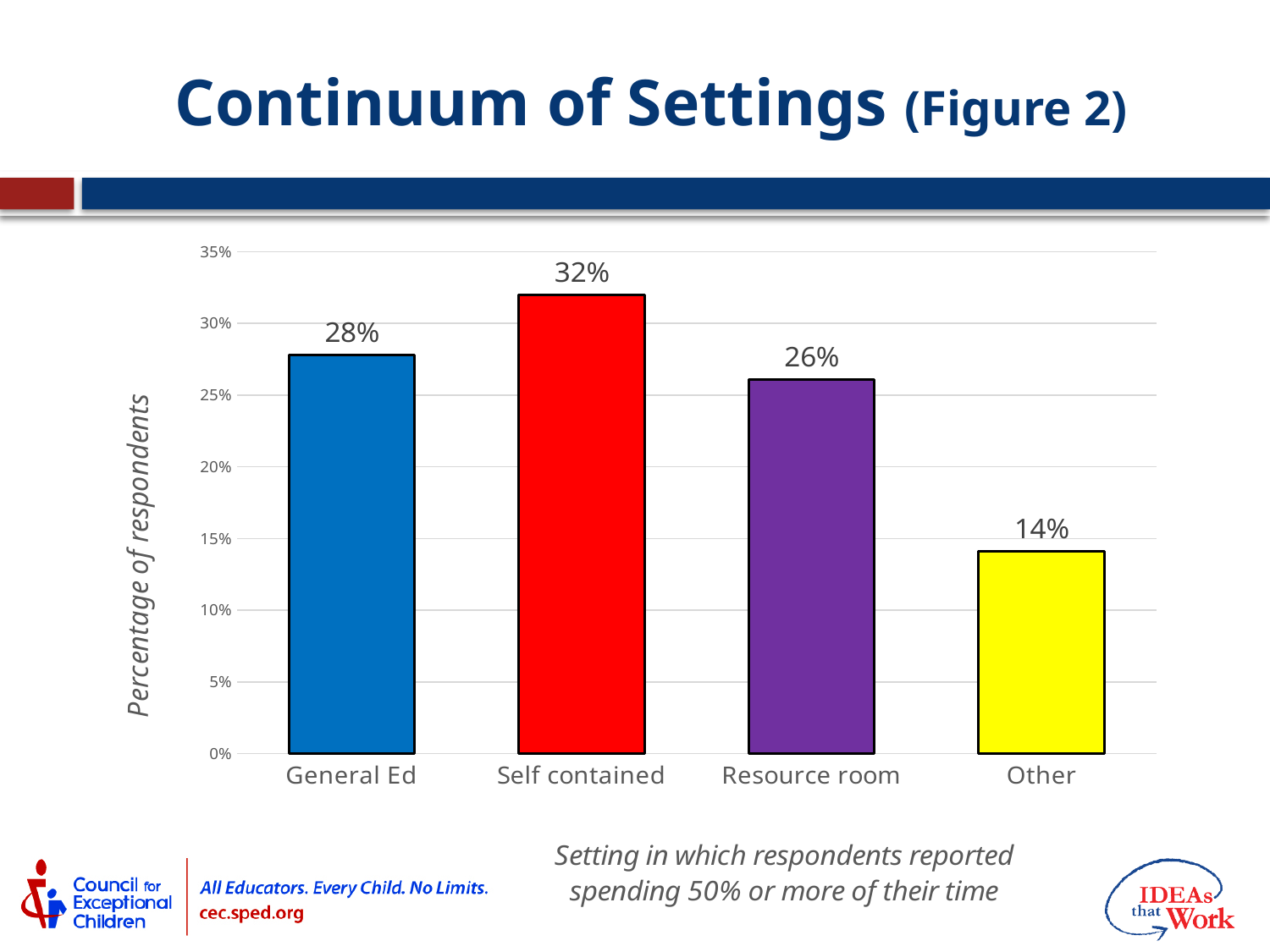
How many settings are shown on the x axis? 4 What is the value shown for Other? 14% What is the value shown for Self contained? 32% What is the value shown for Resource room? 26% What is the difference between the values for Self contained and Other? 18% Which is larger, the value for General Ed or the value for Resource room? General Ed Is the value for Resource room greater or less than 25%? greater What kind of chart is shown on the slide? Bar chart Which setting has the highest percentage of respondents? Self contained Which setting has the lowest percentage of respondents? Other What is the label of the vertical axis? Percentage of respondents What percentage of respondents reported spending 50% or more of their time in General Ed? 28%